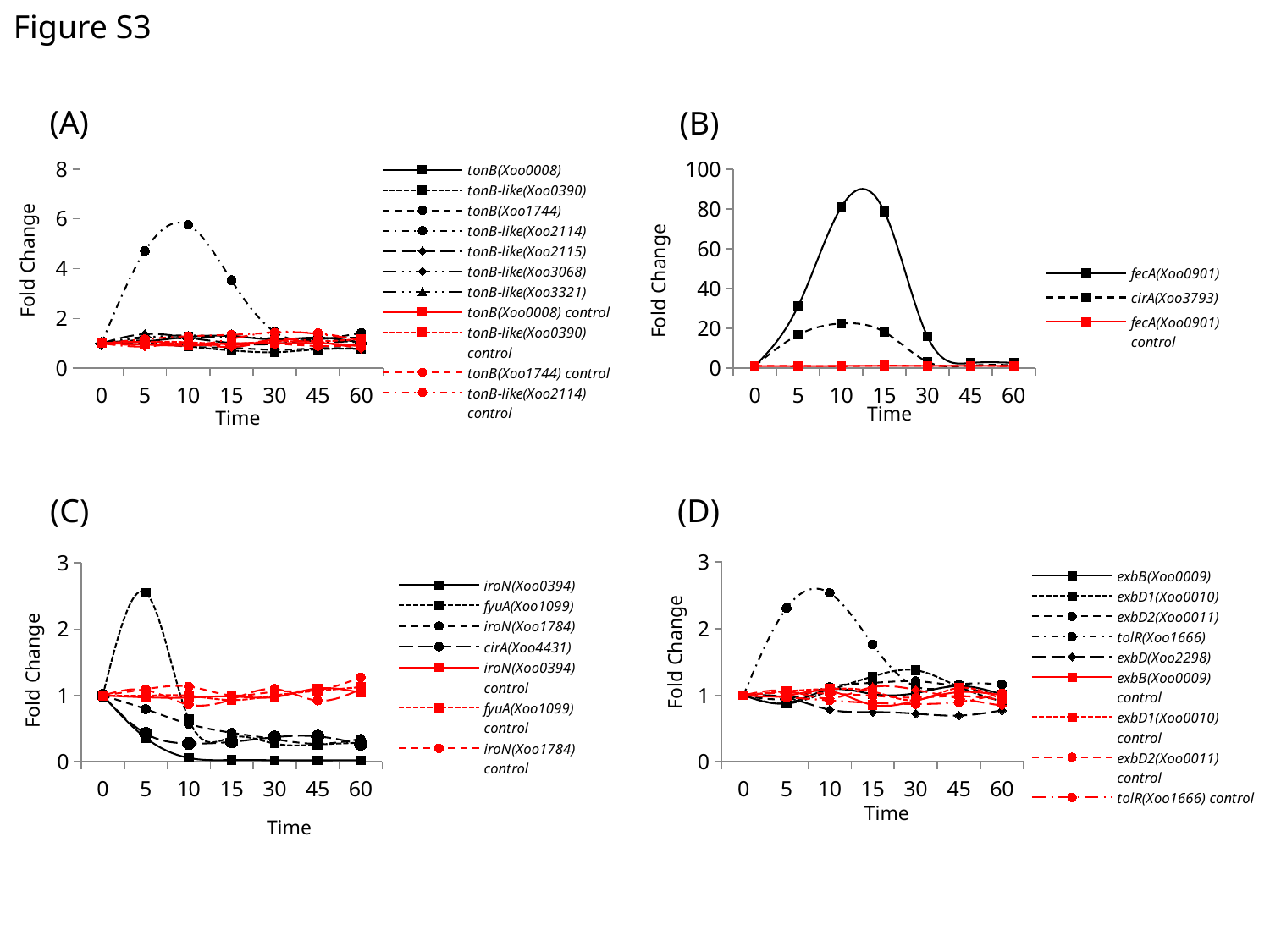
In chart (A), is the value for tonB-like(Xoo2114) at time 10 greater or less than 4? greater In chart (D), is the value for tolR(Xoo1666) at time 10 greater or less than 2? greater How many series does the legend of chart (A) list? 11 In chart (B), is the value for fecA(Xoo0901) at time 10 greater or less than 60? greater How many time points are plotted along the x axis of chart (A)? 7 In chart (B), which series reaches the highest fold change? fecA(Xoo0901) What is the y-axis label of chart (D)? Fold Change In chart (C), does the value for iroN(Xoo0394) rise or fall between time 0 and time 10? fall In chart (B), at time 10, which is larger: fecA(Xoo0901) or cirA(Xoo3793)? fecA(Xoo0901) What kind of chart is chart (A)? line chart How many series does the legend of chart (B) list? 3 How many series does the legend of chart (C) list? 7